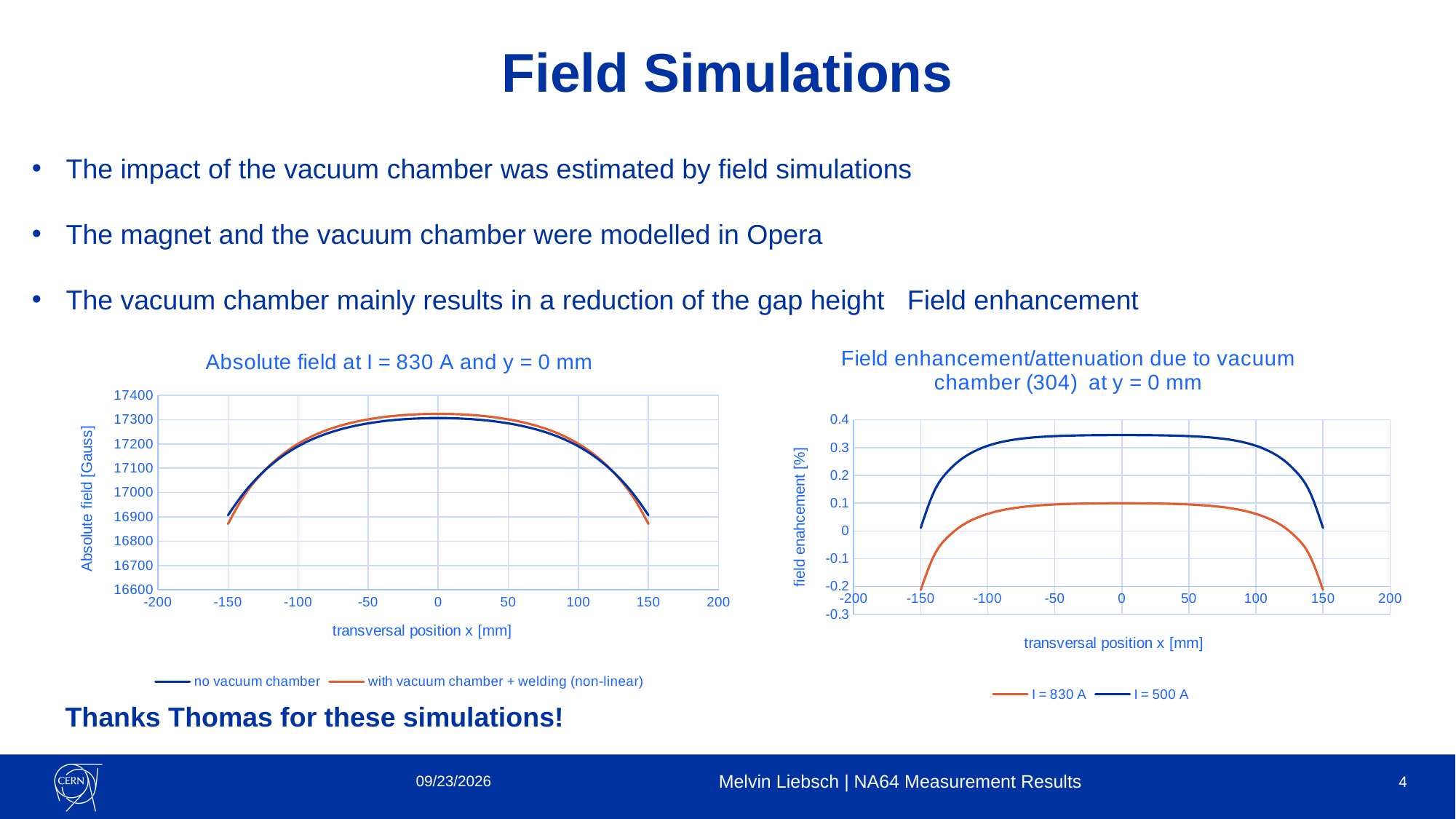
What kind of chart is the left chart titled 'Absolute field at I = 830 A and y = 0 mm'? line chart How many series does the legend of the right chart 'Field enhancement/attenuation due to vacuum chamber (304) at y = 0 mm' list? 2 In the right chart 'Field enhancement/attenuation due to vacuum chamber (304) at y = 0 mm', is the value of the 'I = 500 A' series at x = 0 greater or less than 0.3? greater In the right chart 'Field enhancement/attenuation due to vacuum chamber (304) at y = 0 mm', which series has the higher value at x = 0, 'I = 830 A' or 'I = 500 A'? I = 500 A In the right chart 'Field enhancement/attenuation due to vacuum chamber (304) at y = 0 mm', is the value of the 'I = 830 A' series at x = 0 greater or less than 0.2? less In the left chart 'Absolute field at I = 830 A and y = 0 mm', is the value of the 'with vacuum chamber + welding (non-linear)' series at x = -150 greater or less than 17000? less What is the y-axis title of the left chart 'Absolute field at I = 830 A and y = 0 mm'? Absolute field [Gauss] In the right chart 'Field enhancement/attenuation due to vacuum chamber (304) at y = 0 mm', do the values of the 'I = 830 A' series rise or fall as x goes from 100 to 150? fall In the left chart 'Absolute field at I = 830 A and y = 0 mm', do the values rise or fall as x goes from -150 to 0? rise In the left chart 'Absolute field at I = 830 A and y = 0 mm', which series has the higher value at x = 0, 'no vacuum chamber' or 'with vacuum chamber + welding (non-linear)'? with vacuum chamber + welding (non-linear) How many series does the legend of the left chart 'Absolute field at I = 830 A and y = 0 mm' list? 2